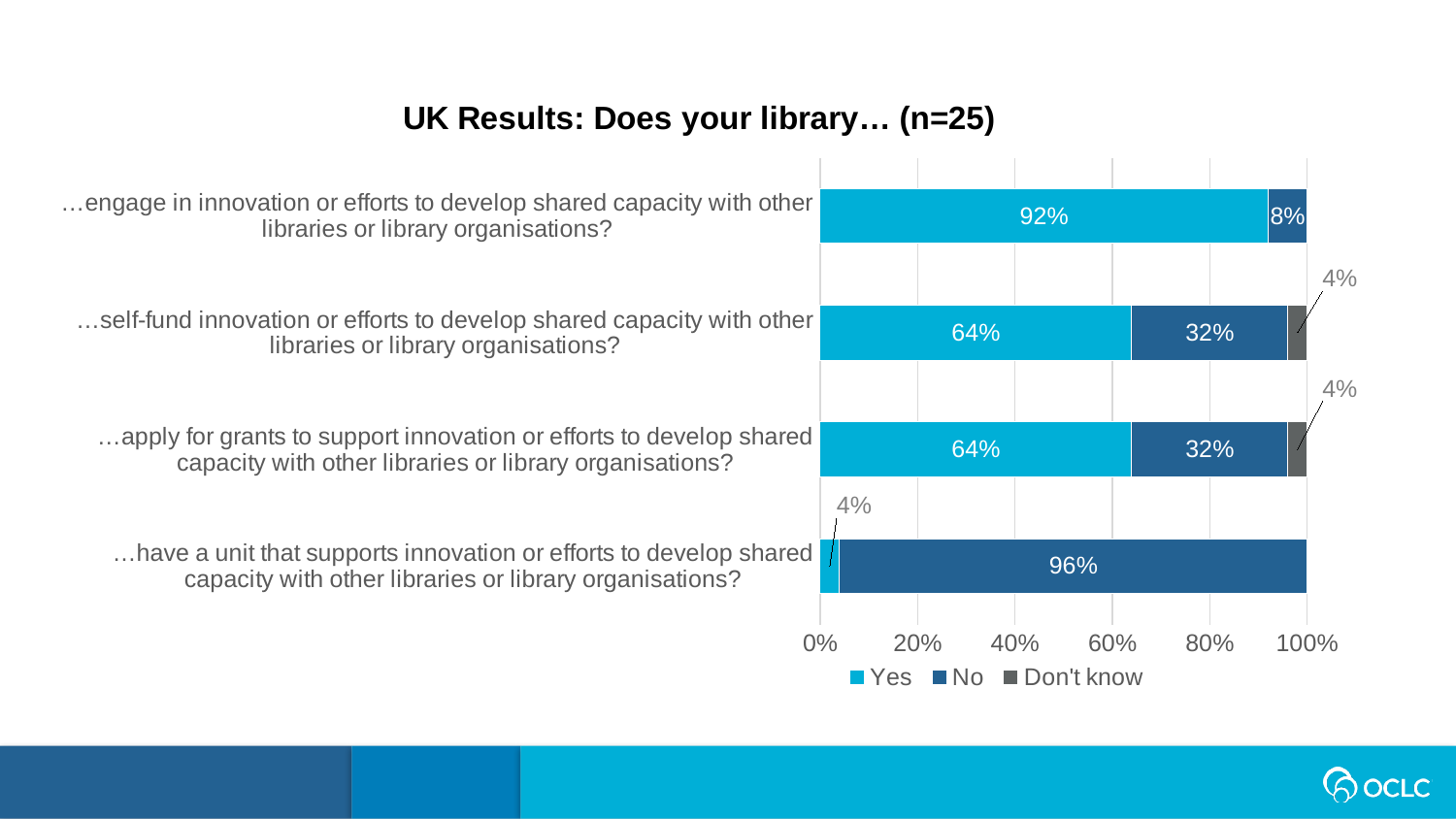
What percentage answered "Yes" to applying for grants to support innovation or efforts to develop shared capacity? 64% What percentage answered "Don't know" for self-funding innovation or efforts to develop shared capacity? 4% Which question received the highest "Yes" percentage? …engage in innovation or efforts to develop shared capacity with other libraries or library organisations? What kind of chart is shown on the slide? Stacked bar chart How many series does the legend list? 3 Which question received the lowest "Yes" percentage? …have a unit that supports innovation or efforts to develop shared capacity with other libraries or library organisations? How many survey questions (categories) are shown in the chart? 4 What percentage of UK libraries answered "Yes" to engaging in innovation or efforts to develop shared capacity with other libraries or library organisations? 92% Is the "No" percentage larger for having a unit that supports innovation or for engaging in innovation? …have a unit that supports innovation or efforts to develop shared capacity with other libraries or library organisations? What is the sample size (n) given in the chart title? 25 What percentage of UK libraries answered "No" to having a unit that supports innovation or efforts to develop shared capacity? 96% What is the difference between the "Yes" percentage for engaging in innovation and the "Yes" percentage for self-funding innovation? 28%